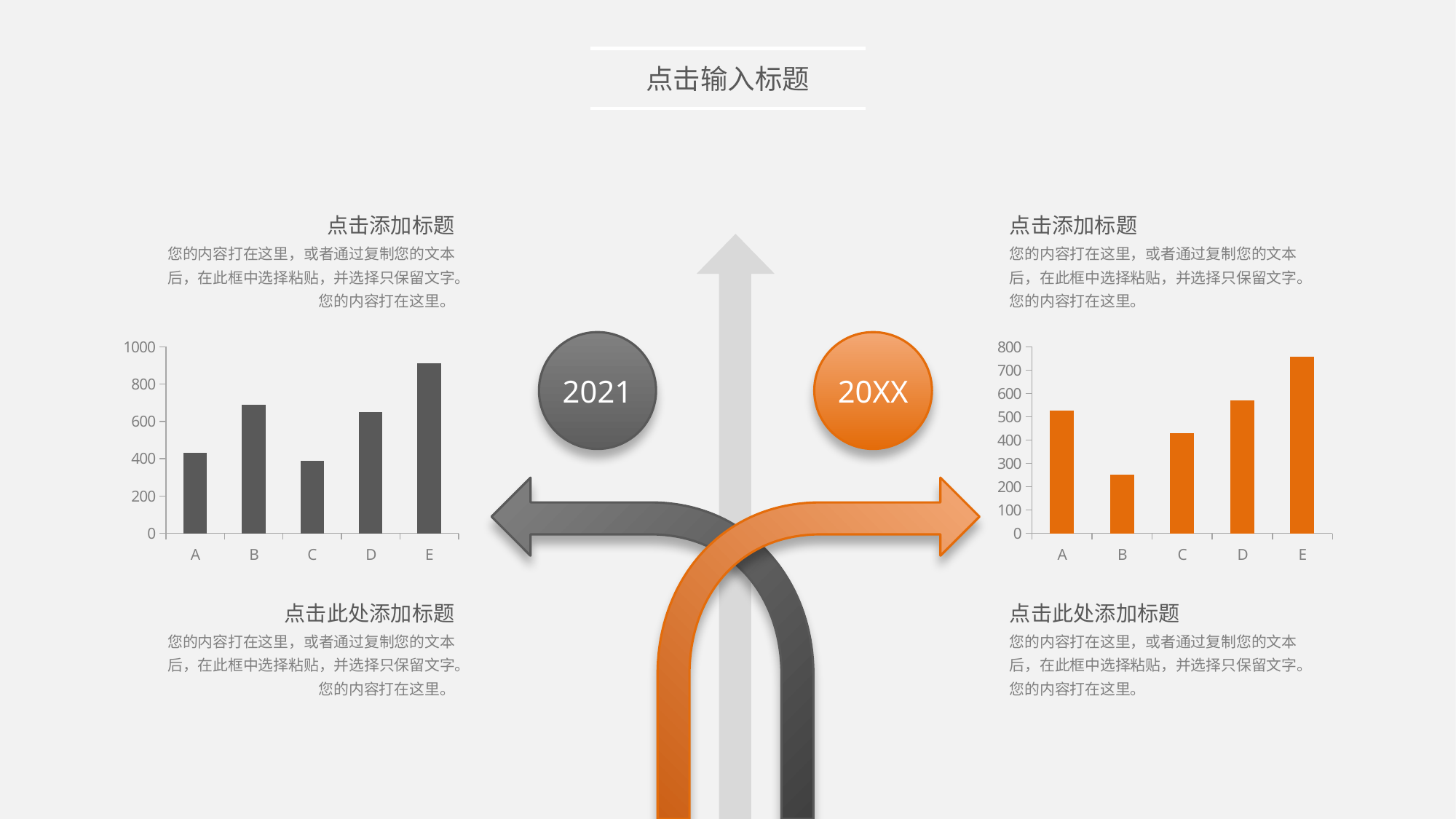
In the right chart, which category has the highest value? E What colour are the bars in the right chart? orange In the left chart, is the value for D greater or less than 600? greater In the right chart, is the value for E greater or less than 700? greater What kind of chart is the left chart on the slide? bar chart In the left chart, which category has the highest value? E In the left chart, which category has the lowest value? C In the left chart, is the value for E greater or less than 800? greater In the right chart, which category has the lowest value? B How many categories does the right chart show? 5 In the right chart, which is larger, the value for C or the value for B? C